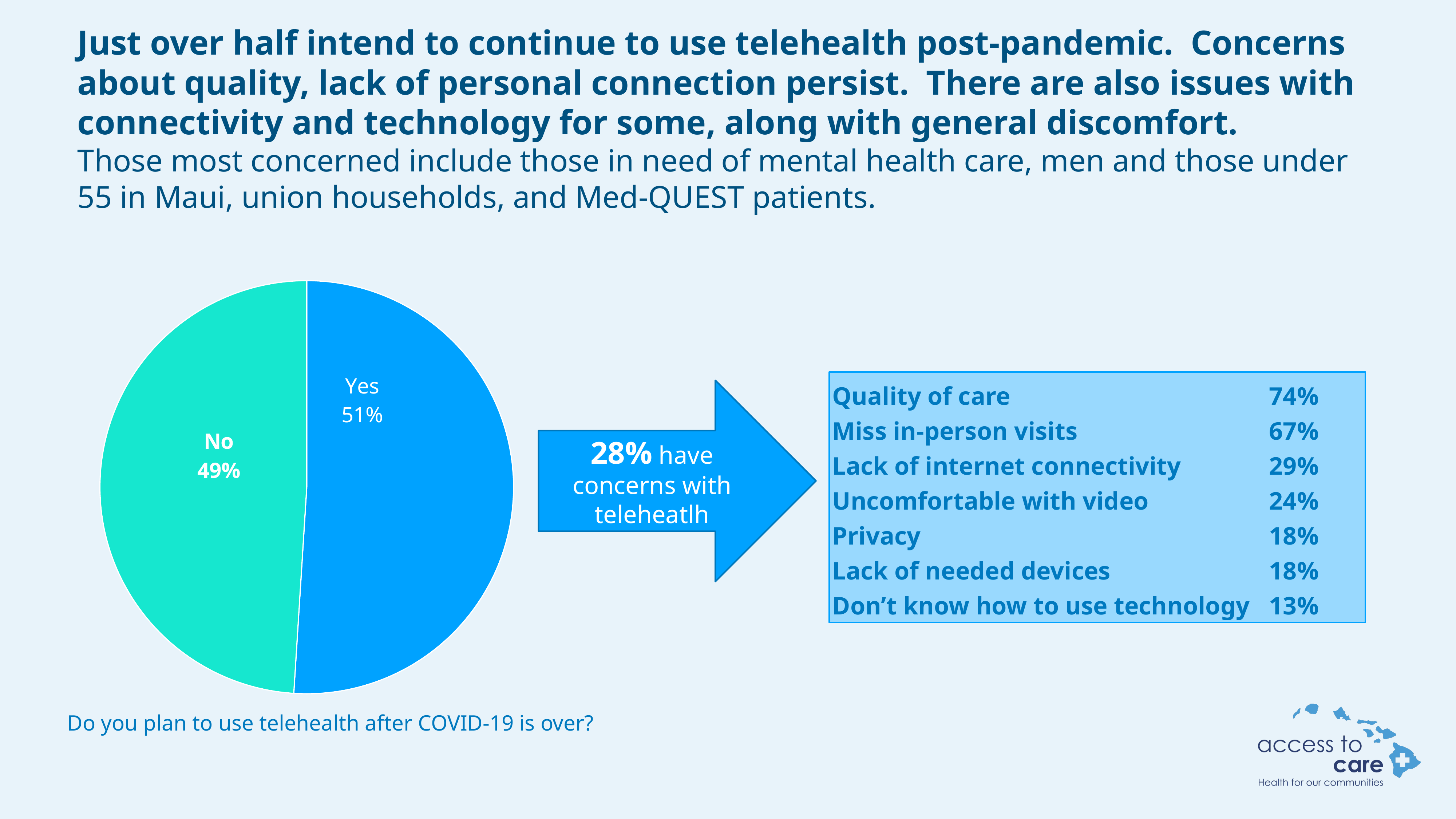
What colour is the "No" slice of the pie chart? Teal/green What survey question does the pie chart answer, as printed below it? Do you plan to use telehealth after COVID-19 is over? What is the difference in percentage points between the Yes and No slices of the pie chart? 2 percentage points How many slices does the pie chart have? 2 Which slice of the pie chart is larger, Yes or No? Yes What is the total of the two slices in the pie chart? 100% What share of the pie chart is labelled "Yes"? 51% What share of the pie chart is labelled "No"? 49% Is the Yes slice of the pie chart greater or less than 50%? greater What kind of chart is shown on the slide? Pie chart